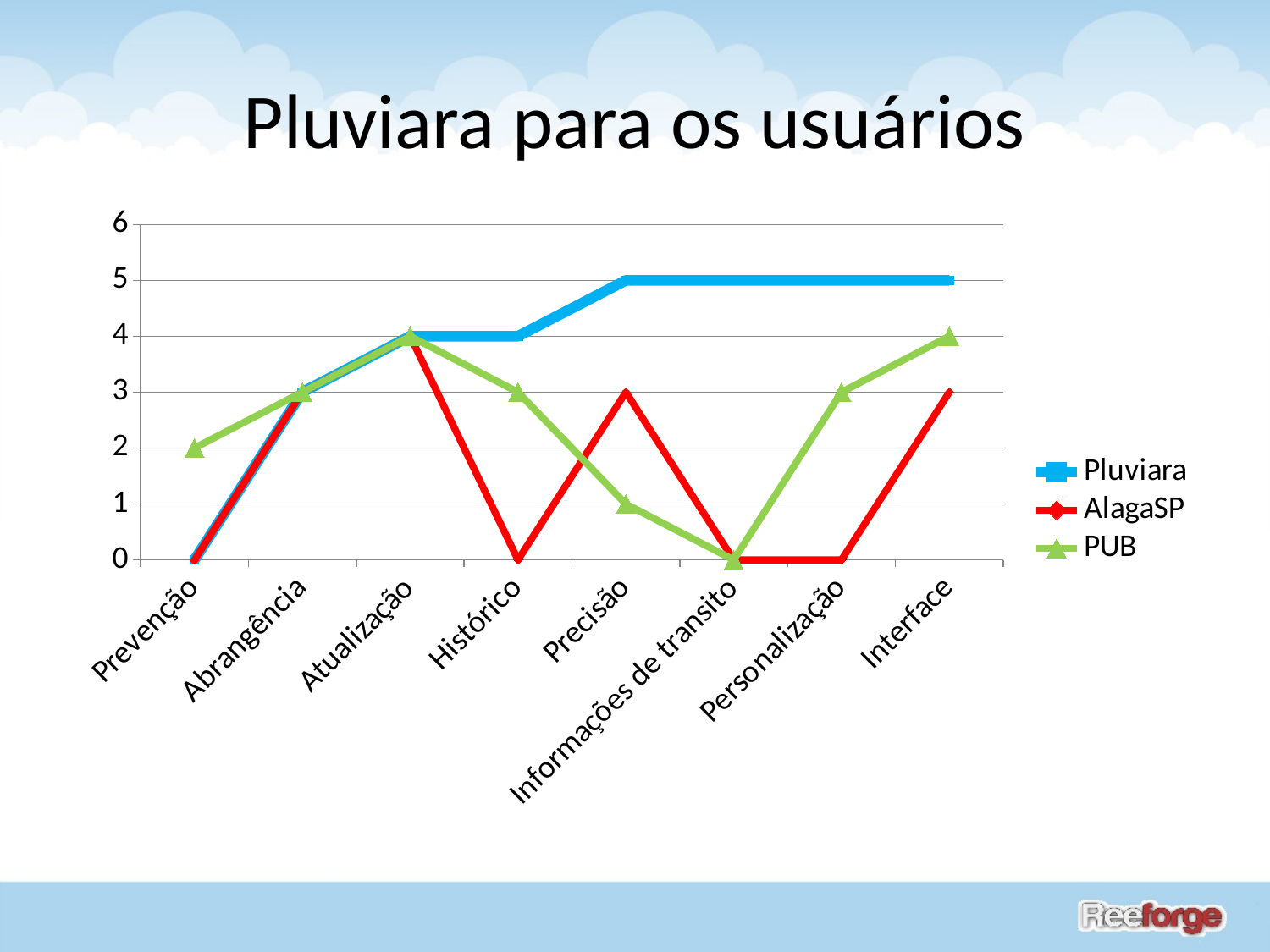
How many series does the legend list? 3 What is the difference between Pluviara and AlagaSP at Personalização? 5 What is the value for Pluviara at Precisão? 5 What is the value for PUB at Interface? 4 What kind of chart is shown on the slide? line chart How many categories are shown on the x axis? 8 Which is larger at Histórico, the value for Pluviara or the value for PUB? Pluviara Which series has the highest value at Interface? Pluviara What is the value for PUB at Prevenção? 2 Does the Pluviara line rise or fall from Prevenção to Precisão? rise Which series has the lowest value at Precisão? PUB What is the value for AlagaSP at Histórico? 0